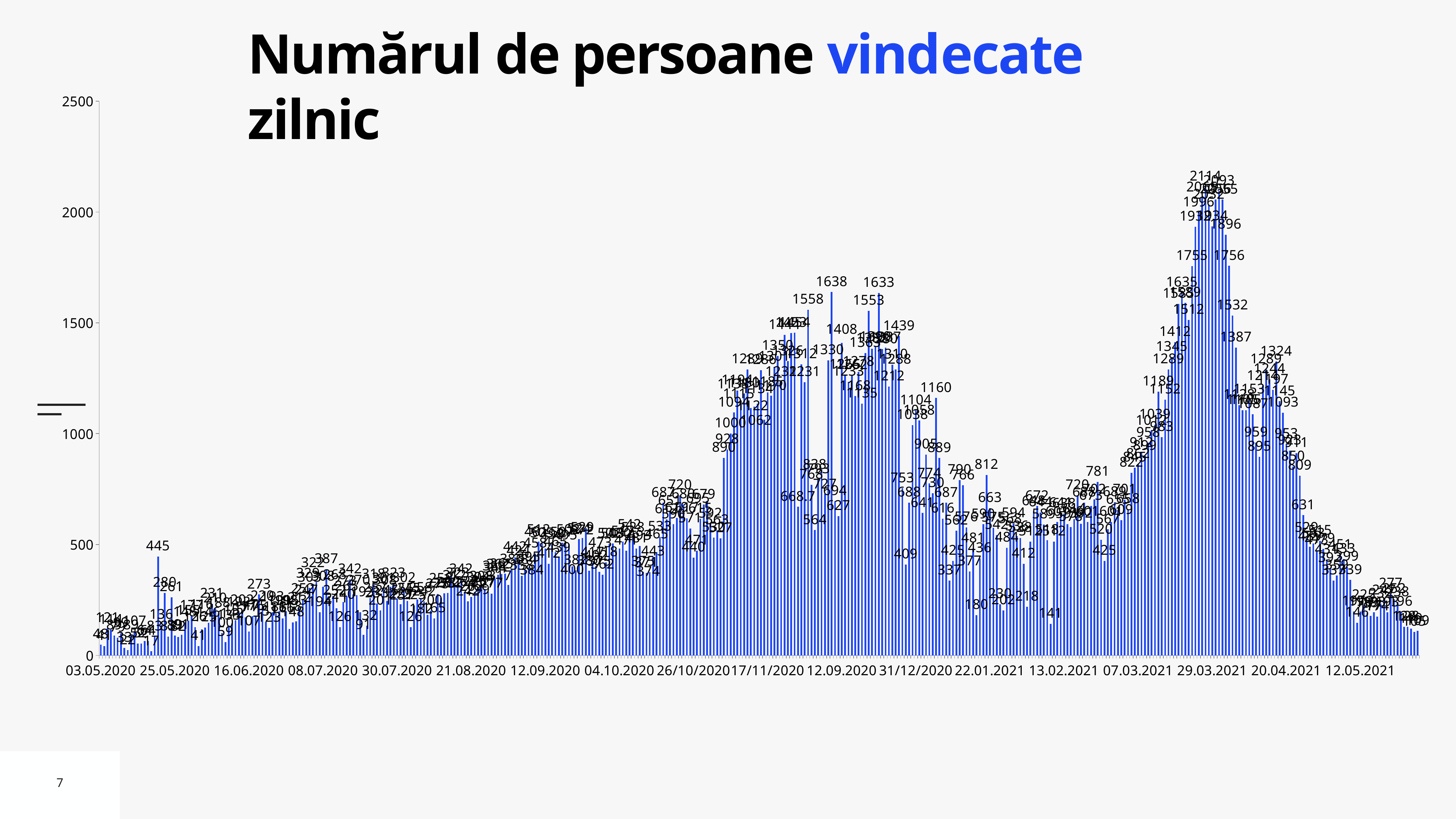
Is the value at the 29.03.2021 tick greater or less than 1500? greater Is the value at the 03.05.2020 tick greater or less than 500? less Do the values rise or fall between 29.03.2021 and 12.05.2021? fall Which is larger, the bar labeled 1755 or the bar labeled 1756? 1756 What is the first date label on the horizontal axis? 03.05.2020 What is the difference between the labeled values 1638 and 1633? 5 Is the value at the 12.05.2021 tick greater or less than 500? less What is the title of the chart? Numărul de persoane vindecate zilnic What is the maximum value shown on the vertical axis? 2500 What kind of chart is shown on the slide? bar chart What is the highest daily value labeled on the chart? 2114 What is the difference between the highest labeled value, 2114, and the labeled peak of 1638? 476